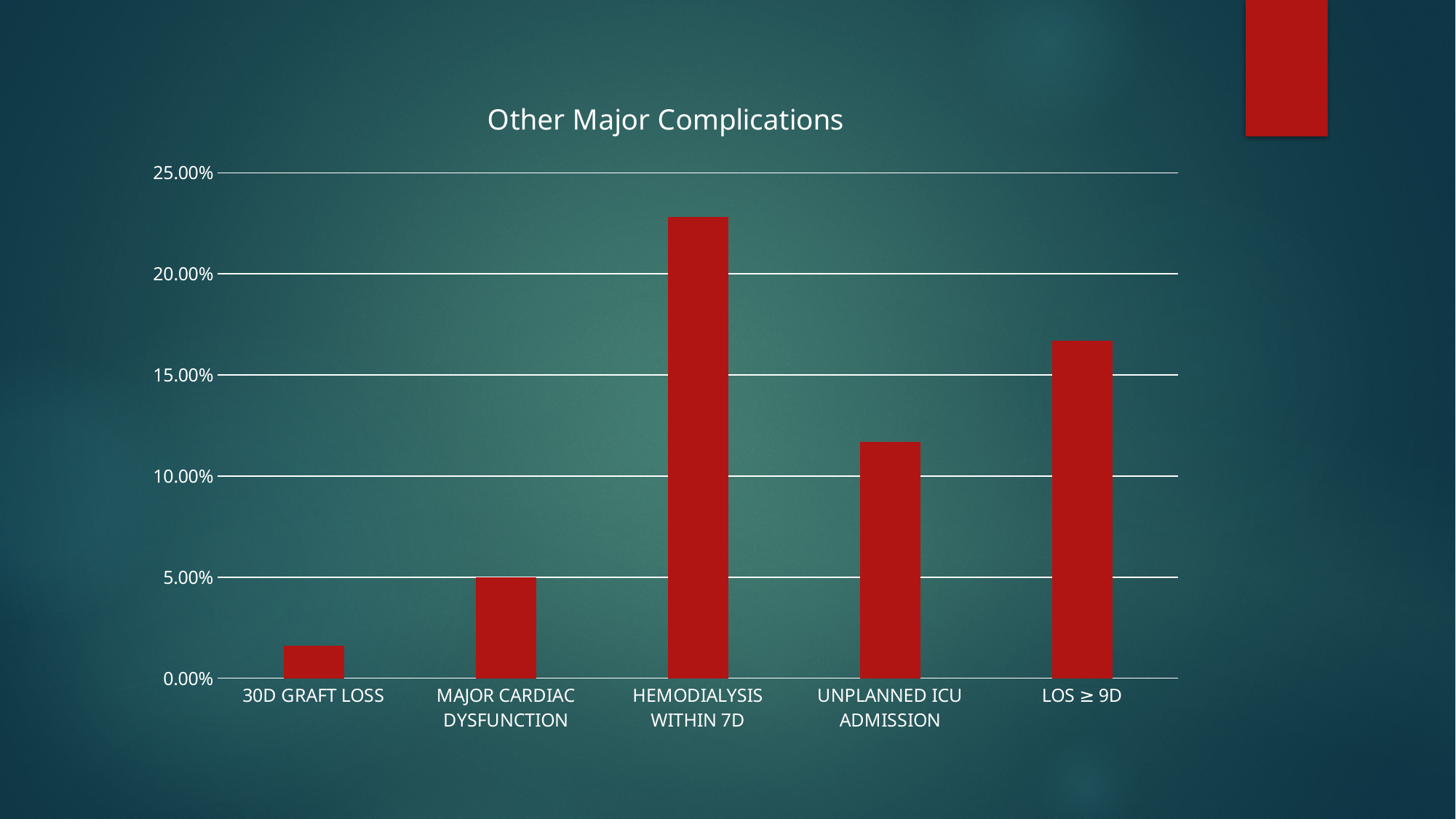
Is the value for Unplanned ICU admission greater or less than 10.00%? greater What colour are the bars in the chart? red Is the value for 30D graft loss greater or less than 5.00%? less Which category has the highest value? Hemodialysis within 7D Is the value for Hemodialysis within 7D greater or less than 20.00%? greater How many categories are shown on the x axis of the chart? 5 Which is larger, the value for LOS ≥ 9D or the value for Unplanned ICU admission? LOS ≥ 9D Which category has the lowest value? 30D graft loss What is the title of the chart? Other Major Complications What kind of chart is shown on the slide? bar chart